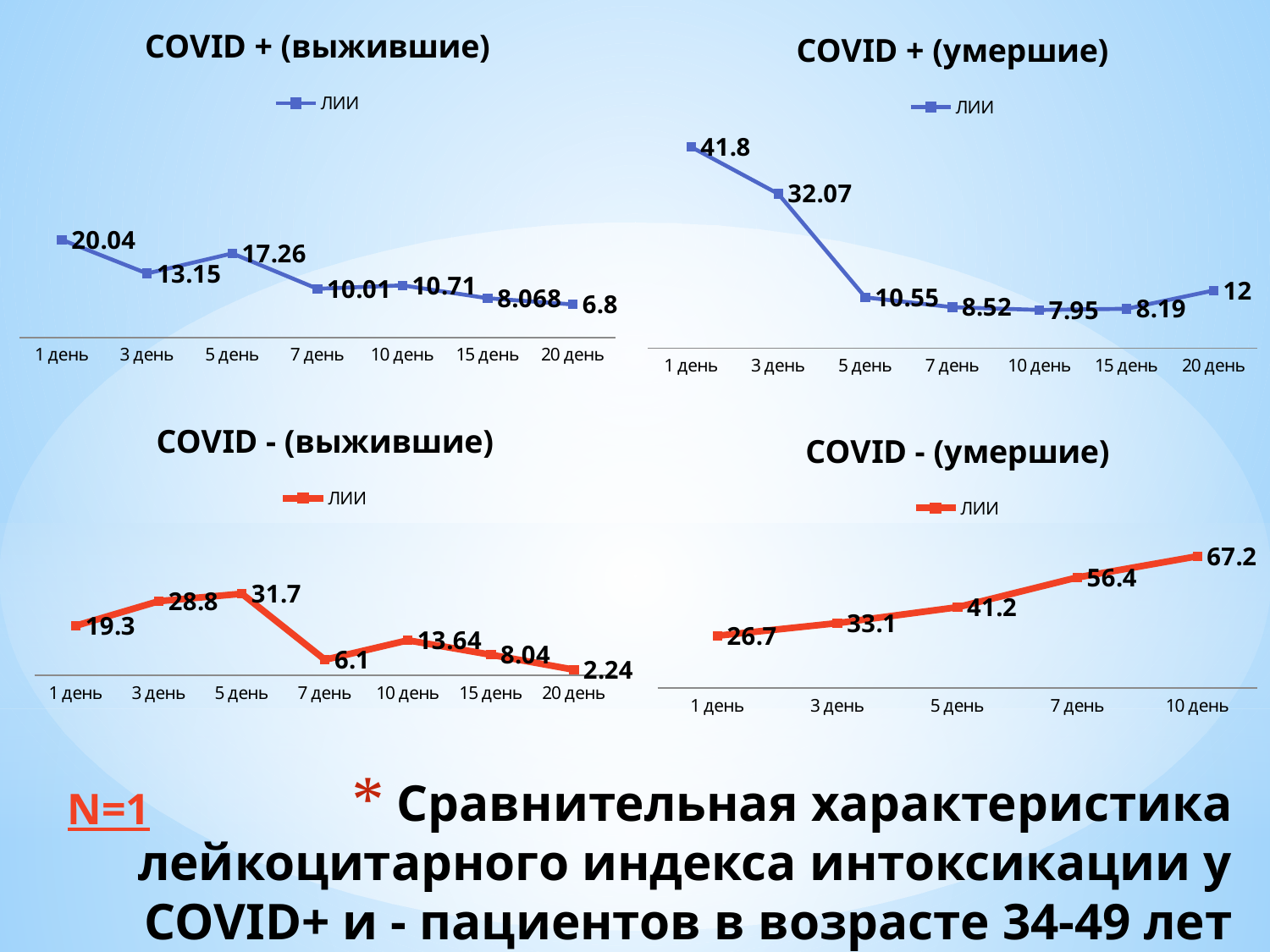
In the 'COVID + (умершие)' chart, what is the ЛИИ value on 3 день? 32.07 In the 'COVID - (умершие)' chart, do the ЛИИ values rise or fall from 1 день to 10 день? Rise What kind of chart is 'COVID - (выжившие)'? Line chart How many data points are plotted in the 'COVID - (умершие)' chart? 5 In the 'COVID + (умершие)' chart, on which day is the ЛИИ value highest? 1 день In the 'COVID + (выжившие)' chart, what is the difference between the ЛИИ values on 1 день and 20 день? 13.24 In the 'COVID + (выжившие)' chart, what is the ЛИИ value on 1 день? 20.04 In the 'COVID - (умершие)' chart, what is the ЛИИ value on 10 день? 67.2 In the 'COVID - (умершие)' chart, what is the difference between the ЛИИ values on 10 день and 1 день? 40.5 In the 'COVID - (выжившие)' chart, on which day is the ЛИИ value lowest? 20 день In the 'COVID - (выжившие)' chart, what is the ЛИИ value on 7 день? 6.1 In the 'COVID + (умершие)' chart, which is larger: the ЛИИ value on 15 день or on 20 день? 20 день